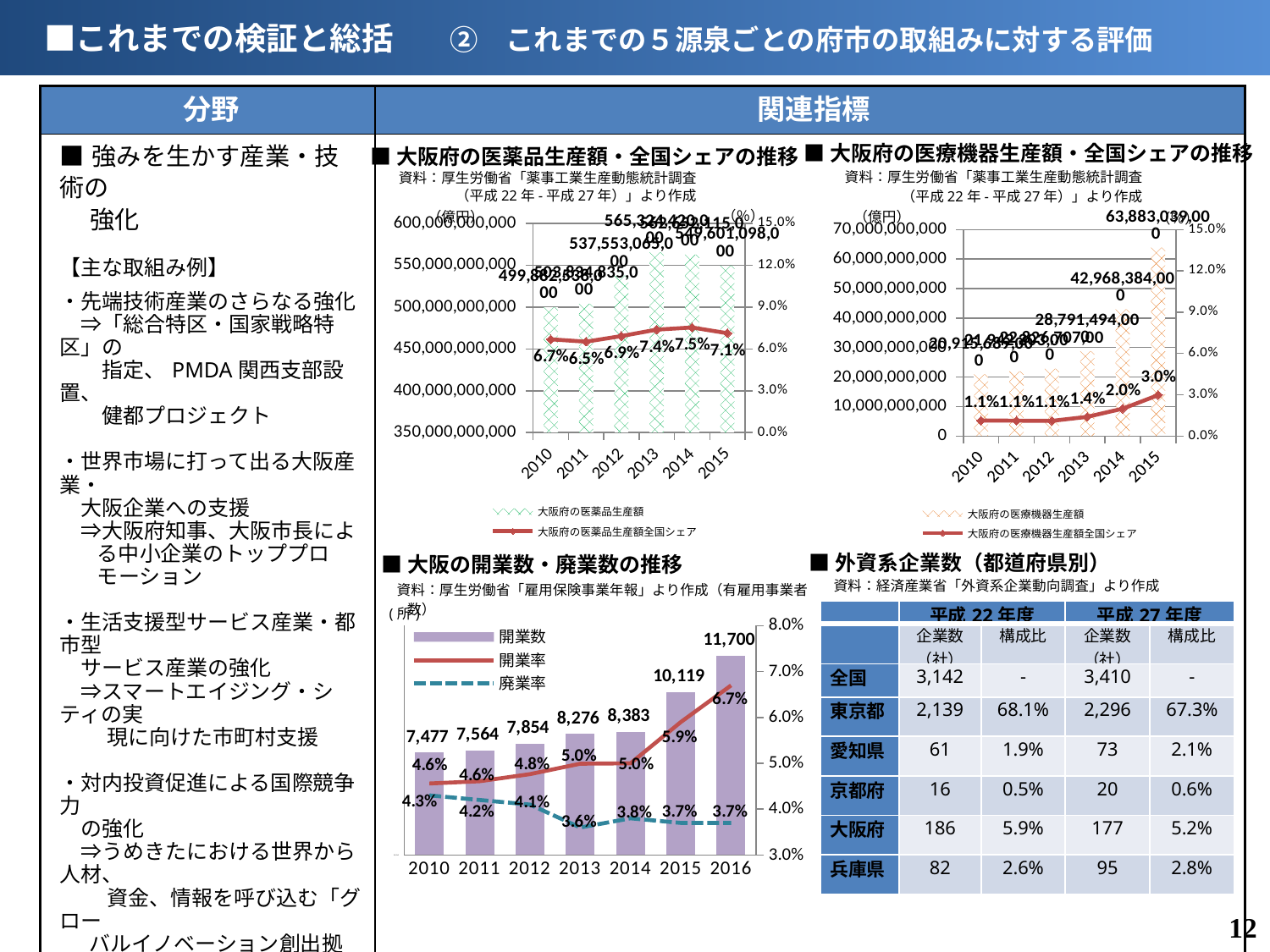
In the chart titled 大阪府の医薬品生産額・全国シェアの推移, which year has the lowest 全国シェア? 2011 In the chart titled 大阪の開業数・廃業数の推移, how many series does the legend list? 3 In the chart titled 大阪府の医薬品生産額・全国シェアの推移, what is the 全国シェア value for 2014? 7.5% In the chart titled 大阪の開業数・廃業数の推移, does the 開業数 rise or fall from 2010 to 2016? rise In the chart titled 大阪の開業数・廃業数の推移, what is the difference between the 開業数 for 2016 and 2015? 1,581 In the chart titled 大阪府の医療機器生産額・全国シェアの推移, is the 全国シェア for 2014 larger or smaller than that for 2013? larger In the chart titled 大阪府の医療機器生産額・全国シェアの推移, what kind of chart is used to show 大阪府の医療機器生産額? bar chart In the chart titled 大阪の開業数・廃業数の推移, what is the 開業率 for 2015? 5.9% In the chart titled 大阪の開業数・廃業数の推移, what is the 開業数 value for 2016? 11,700 In the chart titled 大阪の開業数・廃業数の推移, which year has the lowest 廃業率? 2013 In the chart titled 大阪府の医療機器生産額・全国シェアの推移, what is the 全国シェア value for 2015? 3.0% In the chart titled 大阪の開業数・廃業数の推移, how many years are shown on the x axis? 7